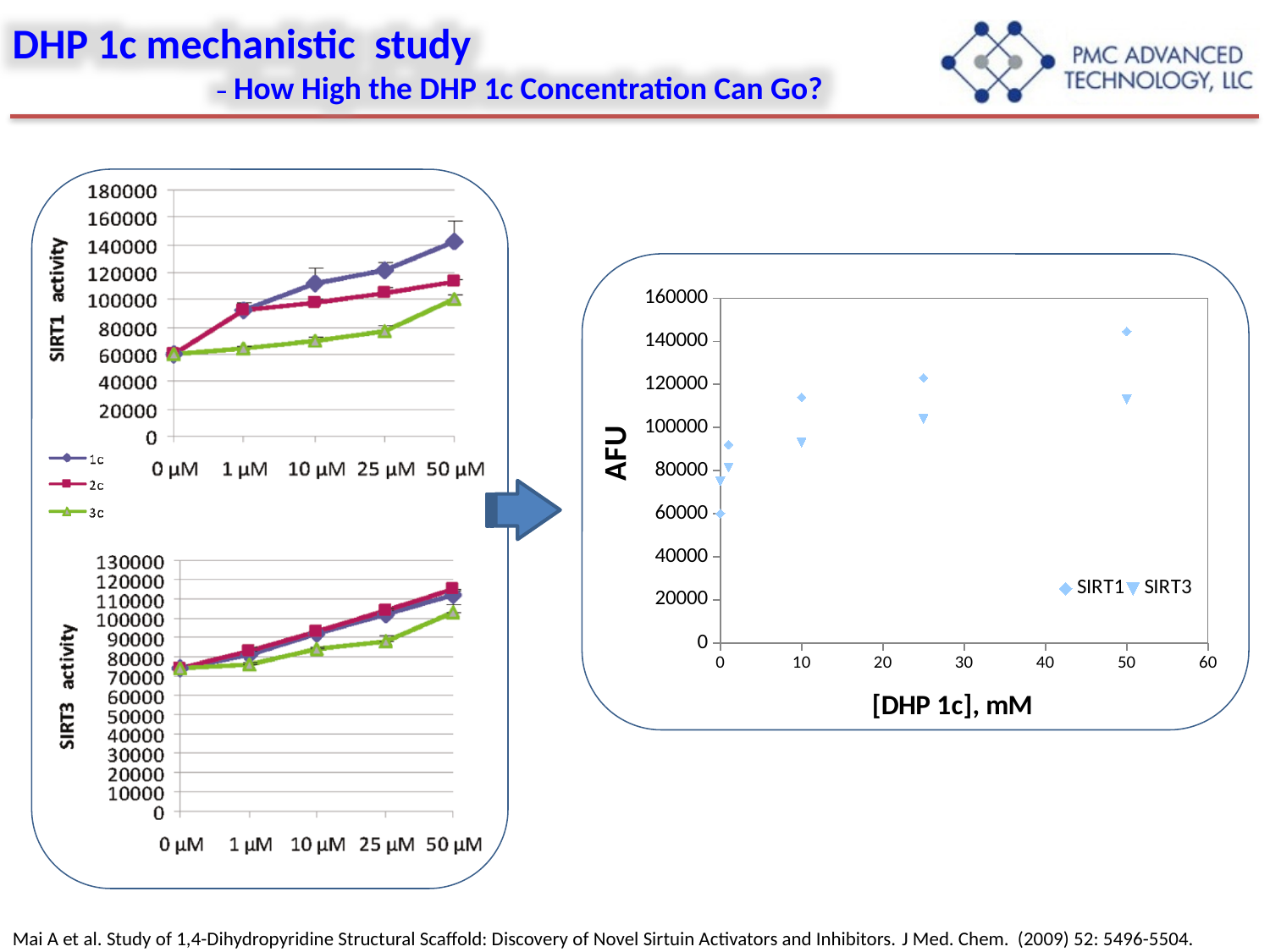
In the top-left SIRT1 activity chart, which series has the highest value at 50 µM? 1c In the top-left SIRT1 activity chart, is the value for 3c at 1 µM greater or less than 80000? less In the right-hand chart (AFU vs [DHP 1c], mM), do the SIRT1 values rise or fall as the concentration increases? rise How many concentration categories are shown on the x axis of the top-left SIRT1 activity chart? 5 What kind of chart is the chart on the right of the slide (AFU vs [DHP 1c], mM)? scatter chart How many series does the legend of the top-left SIRT1 activity chart list? 3 In the right-hand chart (AFU vs [DHP 1c], mM), is the SIRT3 value at 50 mM greater or less than 120000? less How many series does the legend of the right-hand chart (AFU vs [DHP 1c], mM) list? 2 In the right-hand chart (AFU vs [DHP 1c], mM), which series has the higher value at 50 mM, SIRT1 or SIRT3? SIRT1 In the bottom-left SIRT3 activity chart, which series has the lowest value at 50 µM? 3c In the right-hand chart (AFU vs [DHP 1c], mM), is the SIRT1 value at 50 mM greater or less than 140000? greater What is the x-axis label of the right-hand chart? [DHP 1c], mM